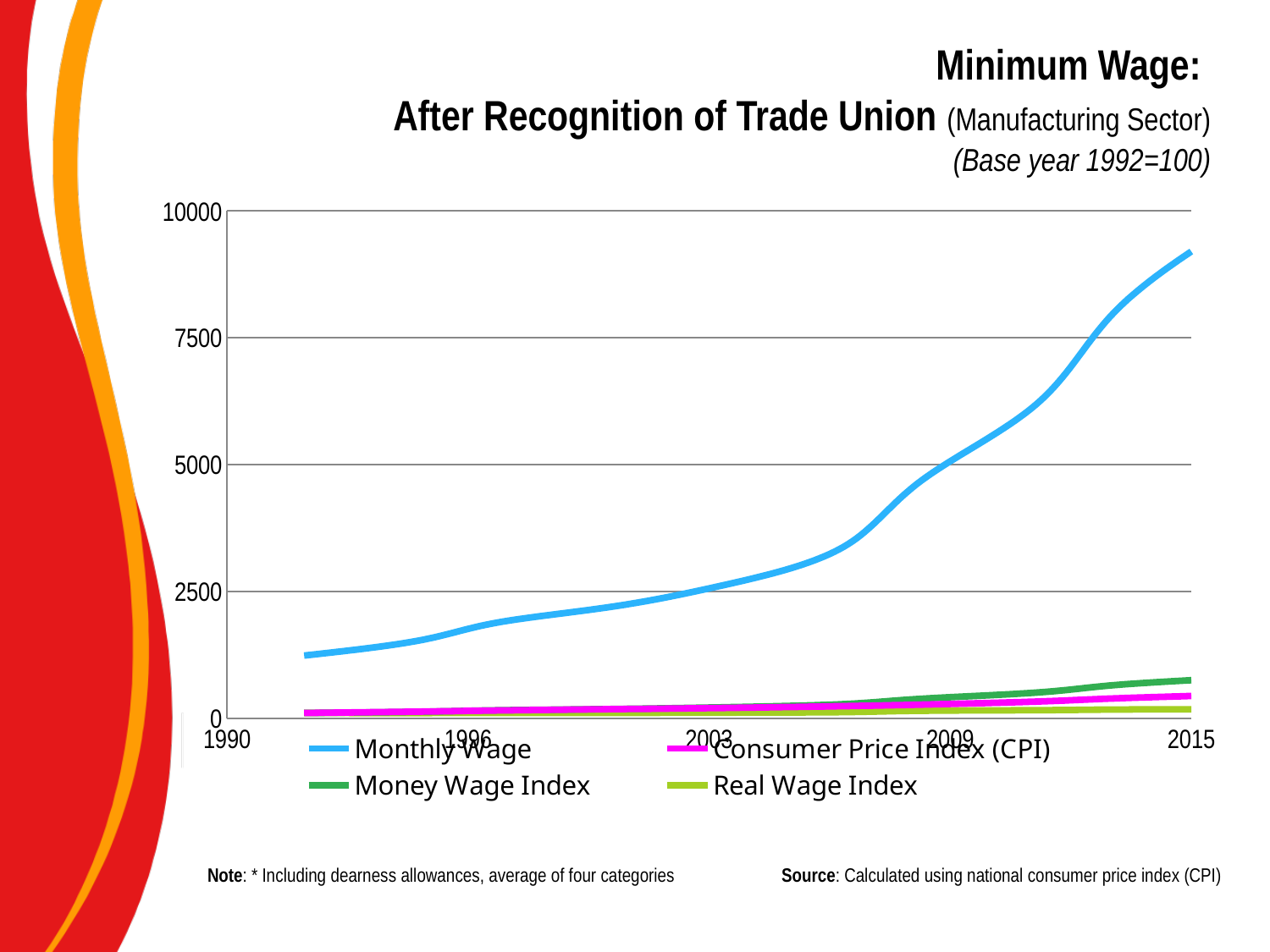
How many series does the legend list? 4 In 2015, which is larger: Monthly Wage or Money Wage Index? Monthly Wage What colour is the Monthly Wage line? Blue Which series stays lowest on the chart? Real Wage Index Is the value of Monthly Wage in 2015 greater or less than 7500? greater What base year is stated in the chart title? 1992=100 In 2015, which is larger: Money Wage Index or Consumer Price Index (CPI)? Money Wage Index Which series reaches the highest value on the chart? Monthly Wage Is the value of Monthly Wage in 1996 greater or less than 2500? less Is the value of the Money Wage Index in 2015 greater or less than 2500? less Does the Monthly Wage line rise or fall from 1990 to 2015? Rises What kind of chart is shown on the slide? Line chart